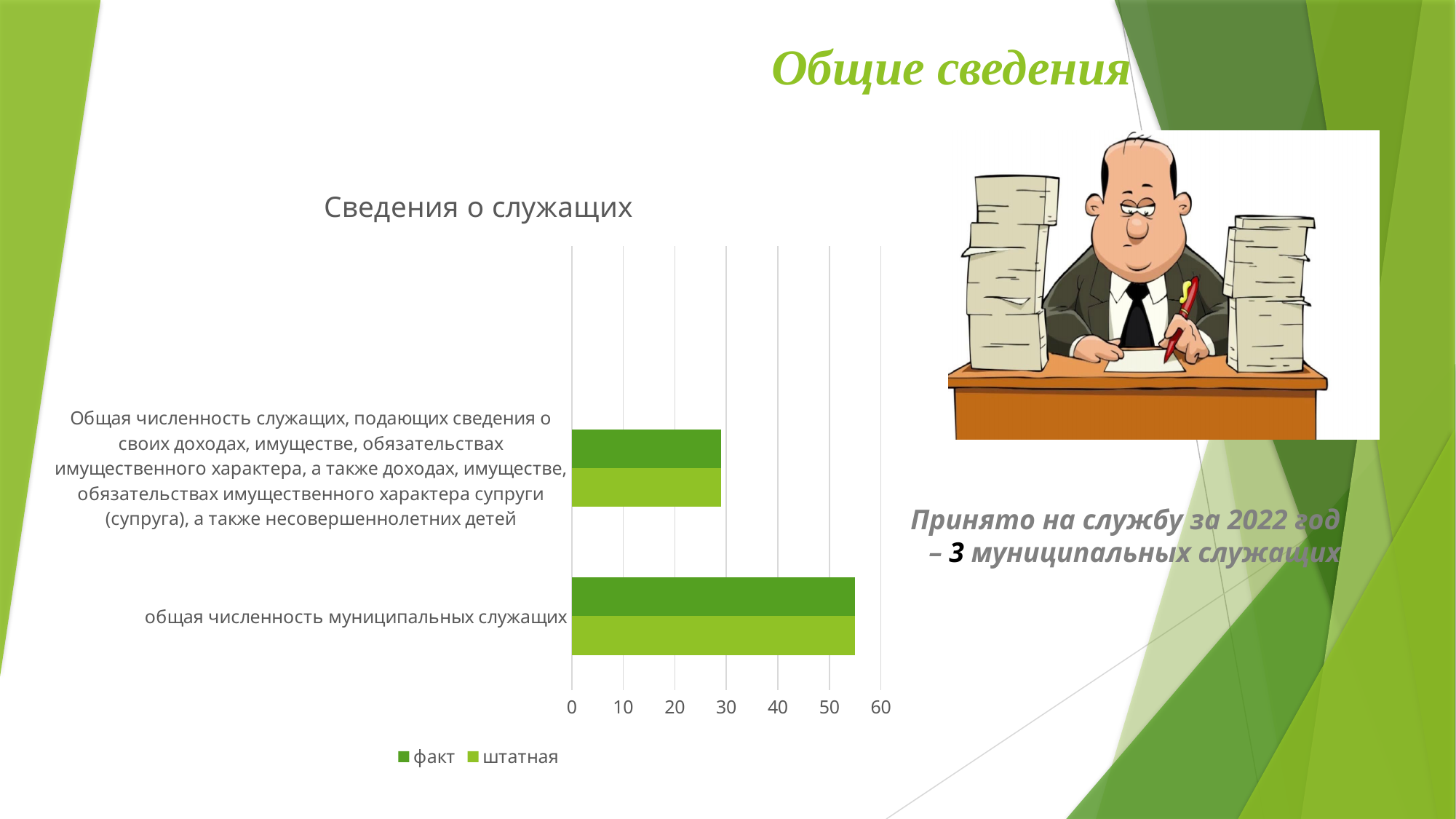
In the chart "Сведения о служащих", is the "факт" value for "общая численность муниципальных служащих" greater or less than 50? greater How many categories are shown in the chart "Сведения о служащих"? 2 In the chart "Сведения о служащих", is the "штатная" value for "Общая численность служащих, подающих сведения о своих доходах..." greater or less than 40? less In the chart "Сведения о служащих", is the "факт" value for "Общая численность служащих, подающих сведения о своих доходах..." greater or less than 20? greater What is the title of the chart on the slide? Сведения о служащих In the chart "Сведения о служащих", is the "факт" value larger for "общая численность муниципальных служащих" or for "Общая численность служащих, подающих сведения о своих доходах..."? общая численность муниципальных служащих What kind of chart is "Сведения о служащих"? bar chart What are the series names in the legend of the chart "Сведения о служащих"? факт, штатная In the chart "Сведения о служащих", which category has the higher "факт" value? общая численность муниципальных служащих How many series does the legend of the chart "Сведения о служащих" list? 2